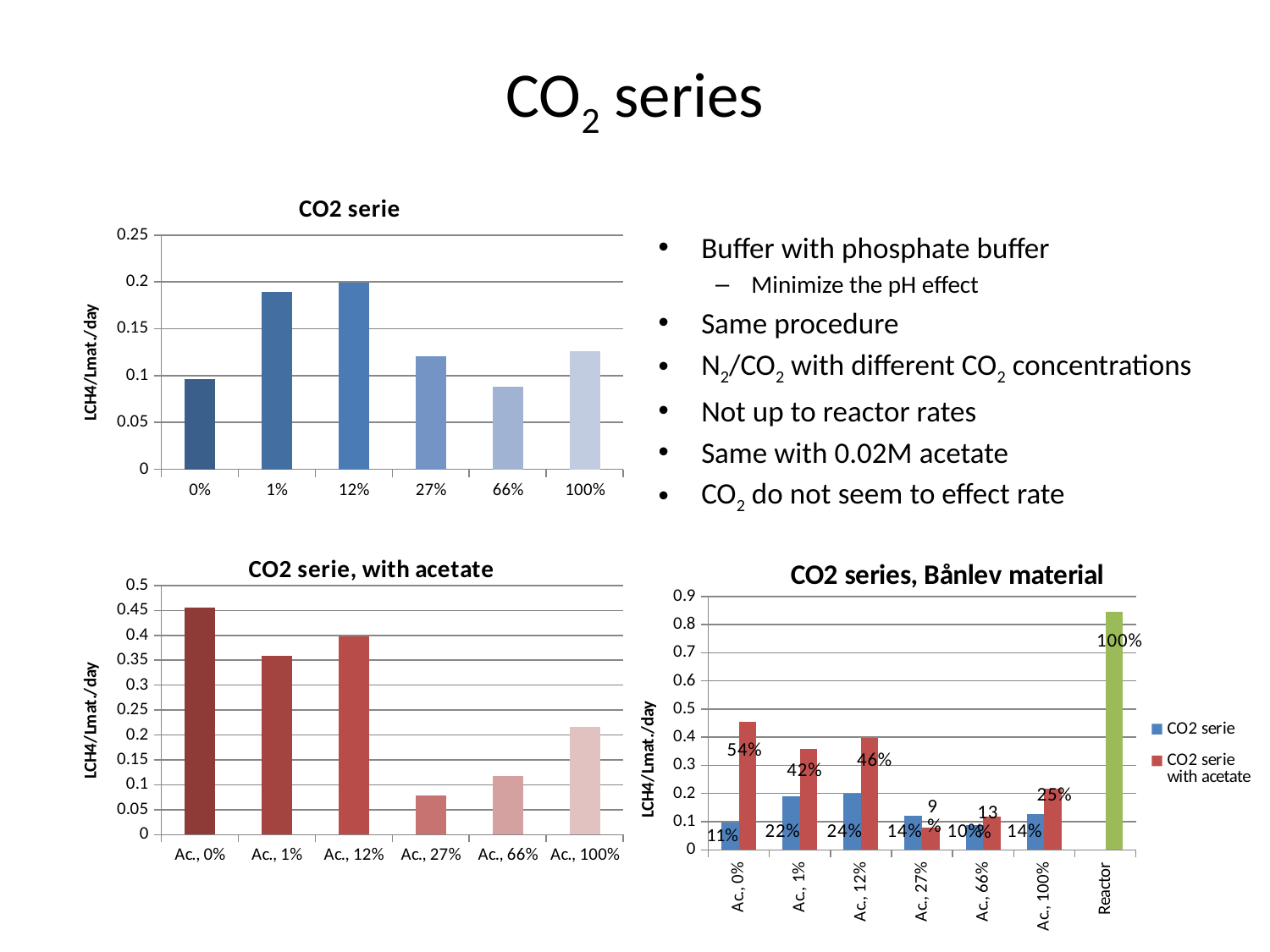
In the "CO2 serie, with acetate" chart at the bottom left, is the value for Ac., 0% greater or less than 0.4? greater In the "CO2 series, Bånlev material" chart, which category has the highest bar? Reactor How many categories are shown on the x axis of the "CO2 serie" chart at the top left? 6 In the "CO2 series, Bånlev material" chart, what data label is shown on the CO2 serie bar for Ac, 12%? 24% In the "CO2 serie, with acetate" chart at the bottom left, which category has the lowest value? Ac., 27% In the "CO2 serie, with acetate" chart at the bottom left, which category has the highest value? Ac., 0% How many series does the legend of the "CO2 series, Bånlev material" chart list? 2 What type of chart is the "CO2 serie" chart at the top left? bar chart In the "CO2 serie, with acetate" chart at the bottom left, which is larger: the value for Ac., 1% or the value for Ac., 66%? Ac., 1% In the "CO2 serie" chart at the top left, is the value for 66% greater or less than 0.1? less In the "CO2 series, Bånlev material" chart, what data label is shown on the CO2 serie with acetate bar for Ac, 0%? 54% In the "CO2 serie" chart at the top left, is the value for 1% greater or less than 0.15? greater